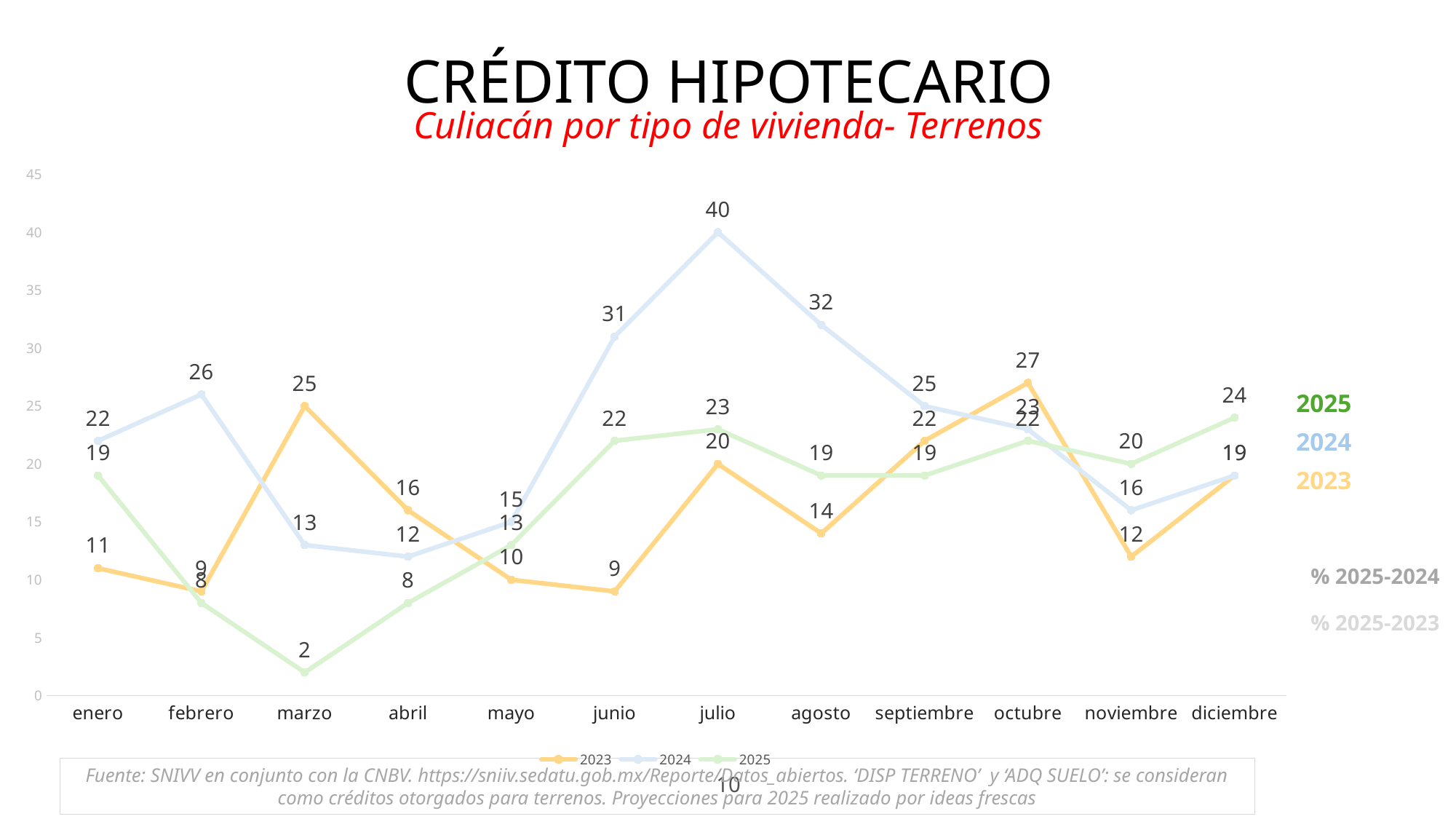
Does the 2024 series rise or fall from julio to noviembre? fall In which month does the 2024 series reach its highest value? julio In which month does the 2025 series have its lowest value? marzo How many months are shown on the x axis? 12 What kind of chart is shown on the slide? line chart In which month does the 2023 series reach its highest value? octubre In marzo, which series has the larger value, 2023 or 2024? 2023 What is the value for 2024 in julio? 40 How many series does the legend list? 3 What is the value for 2025 in enero? 19 What is the value for 2023 in octubre? 27 What is the difference between the 2024 and 2023 values in julio? 20